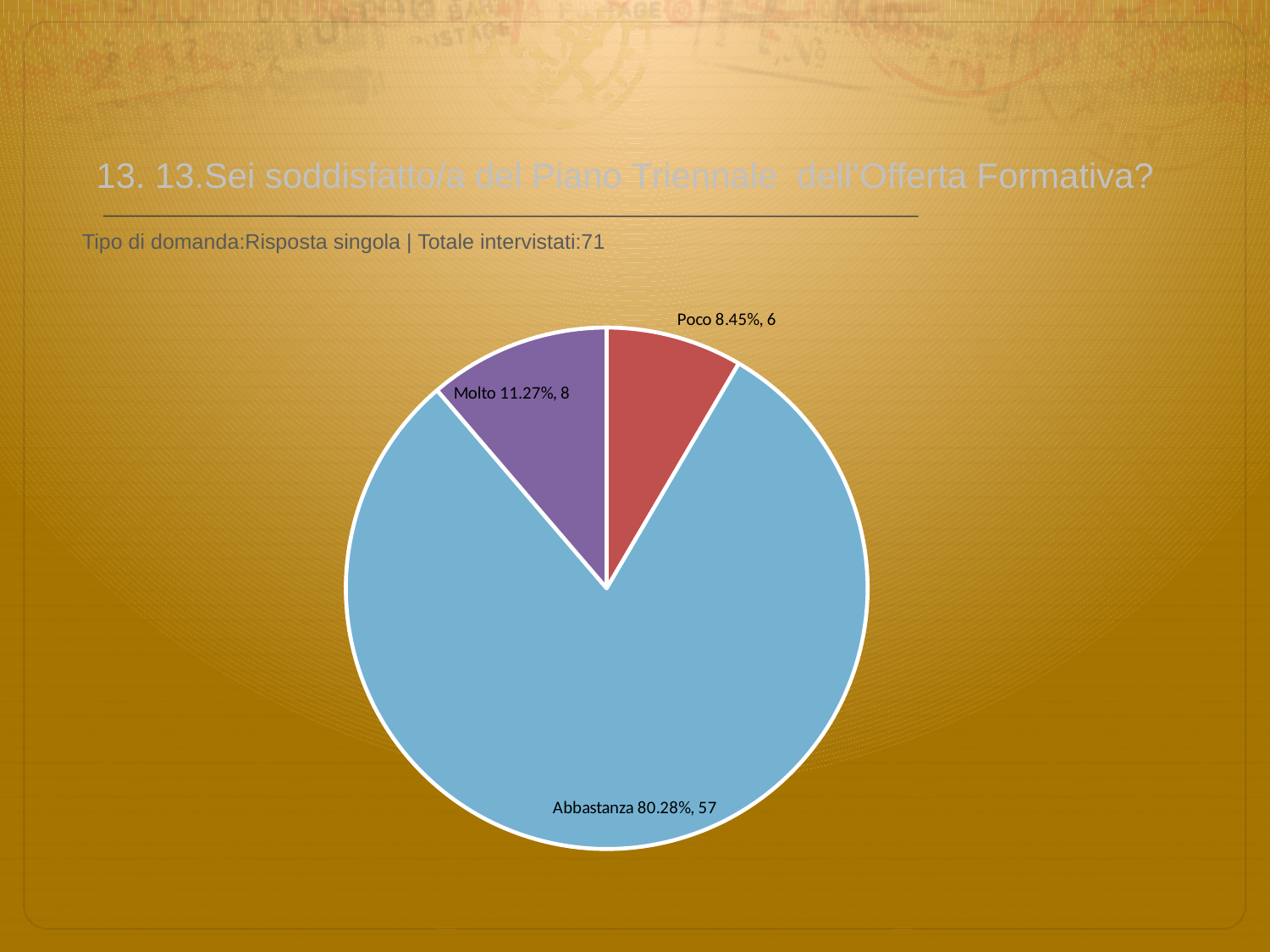
What percentage share does the Abbastanza slice have? 80.28% What kind of chart is shown on the slide? pie chart How many respondents answered Molto? 8 How many respondents answered Poco? 6 What colour is the Abbastanza slice? light blue What is the total number of respondents across all three slices? 71 Which response has the largest slice of the pie? Abbastanza Which response has the smallest slice of the pie? Poco Which has more respondents, Molto or Poco? Molto How many slices does the pie chart have? 3 What is the difference in respondent count between Abbastanza and Molto? 49 What percentage share does the Poco slice have? 8.45%